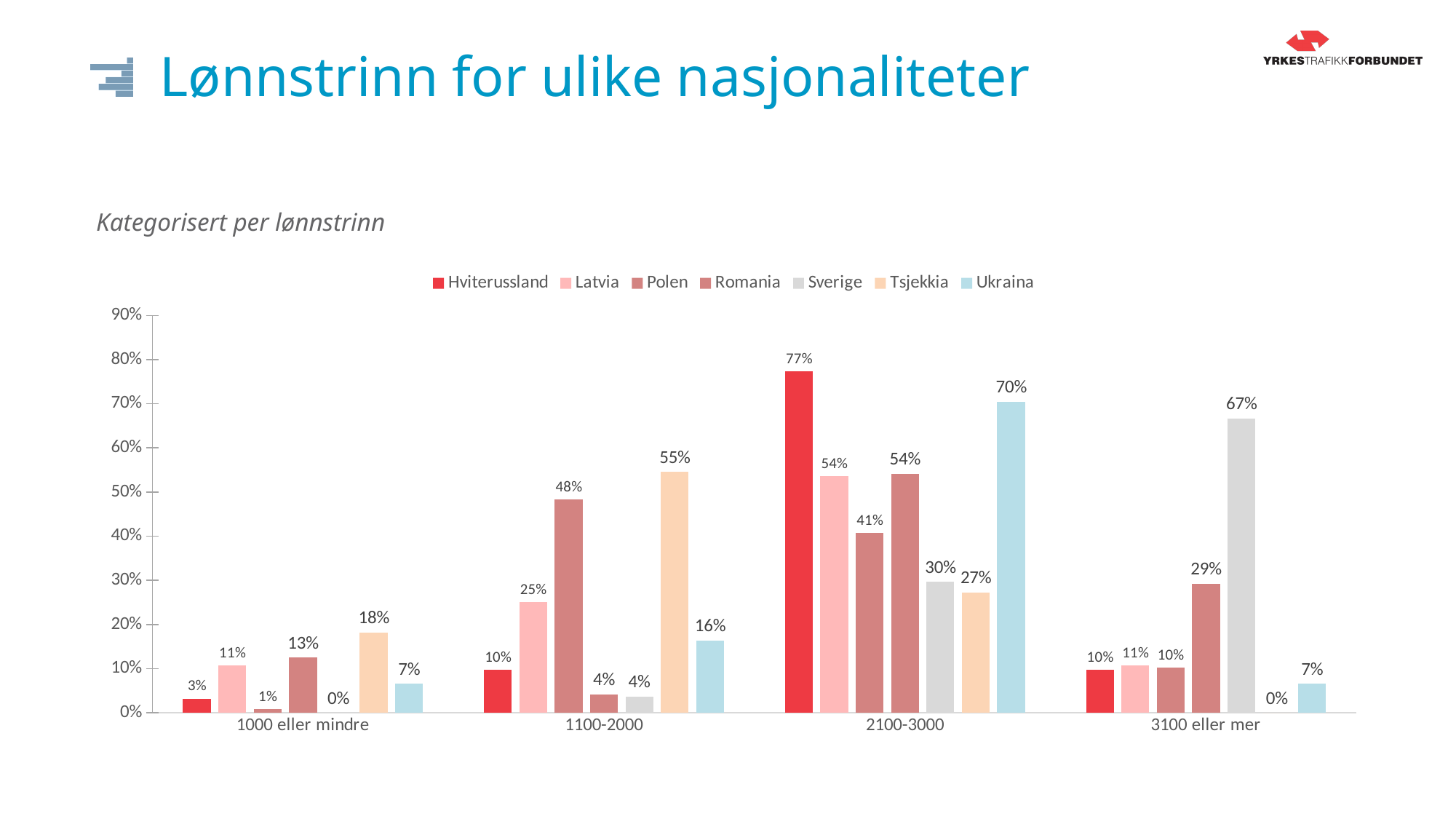
How many salary categories are shown on the x axis? 4 Does the value for Ukraina in the 2100-3000 category rise or fall compared with the 1100-2000 category? rise Which nationality has the lowest value in the 3100 eller mer category? Tsjekkia Which nationality has the highest value in the 1000 eller mindre category? Tsjekkia What is the value for Tsjekkia in the 1100-2000 category? 55% What is the difference between Ukraina and Sverige in the 2100-3000 category? 40% How many series does the legend list? 7 What type of chart is shown on the slide? bar chart What is the value for Sverige in the 3100 eller mer category? 67% What is the value for Hviterussland in the 2100-3000 category? 77% What is the subtitle shown above the chart? Kategorisert per lønnstrinn Which is larger in the 1100-2000 category: Polen or Latvia? Polen